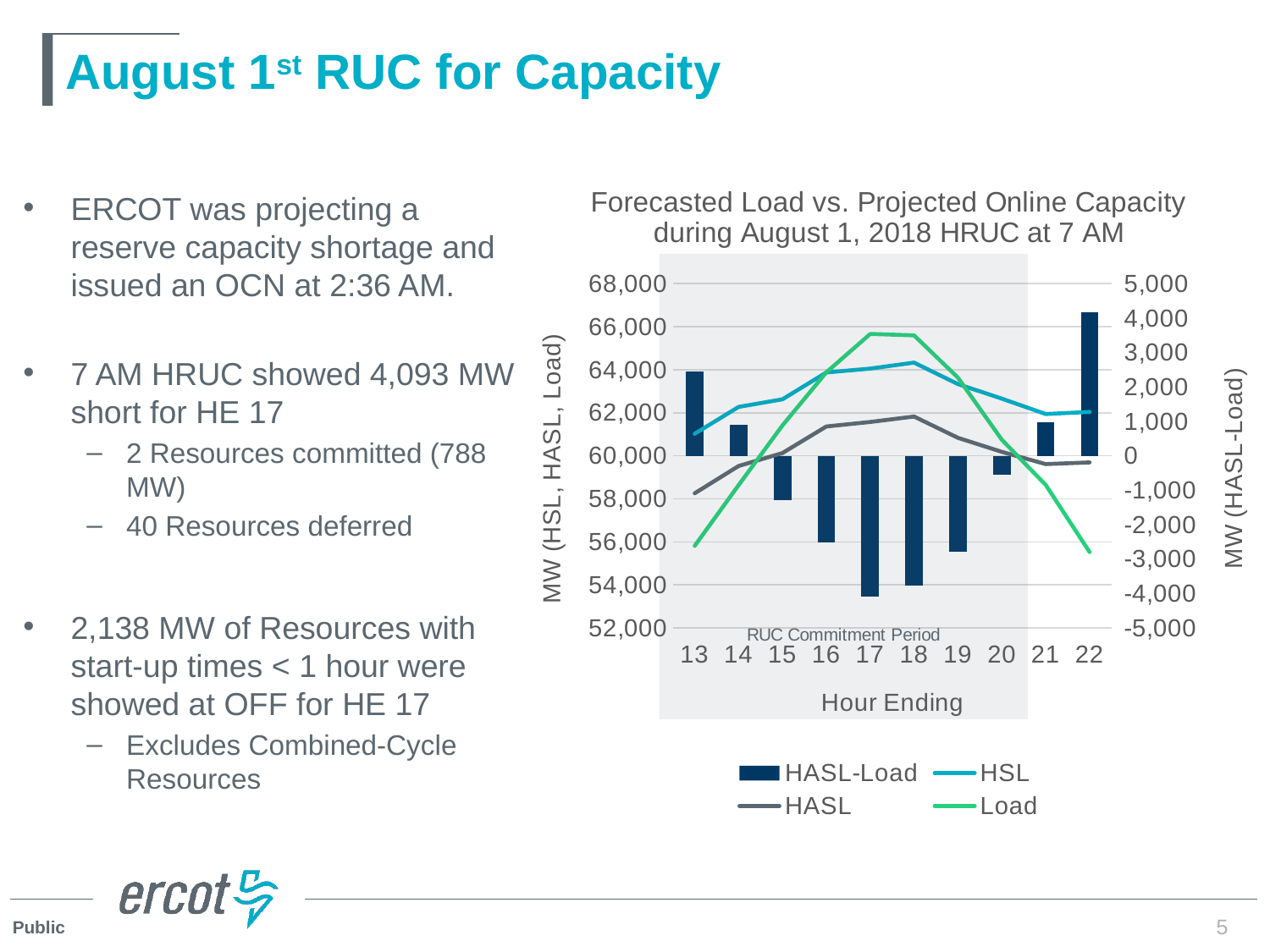
Is the HASL-Load value for Hour Ending 22 greater or less than 3,000? greater Is the HASL-Load value for Hour Ending 17 greater or less than -3,000? less At Hour Ending 17, which is higher, the Load line or the HSL line? Load Is the HASL value for Hour Ending 13 greater or less than 60,000? less How many Hour Ending categories are shown on the x axis? 10 At which Hour Ending is the HASL-Load bar highest? 22 How many series does the chart legend list? 4 At which Hour Ending is the HASL-Load bar lowest? 17 What kind of chart is shown on the slide? A combined bar and line chart Does the Load line rise or fall from Hour Ending 13 to Hour Ending 17? rise What is the title of the chart? Forecasted Load vs. Projected Online Capacity during August 1, 2018 HRUC at 7 AM